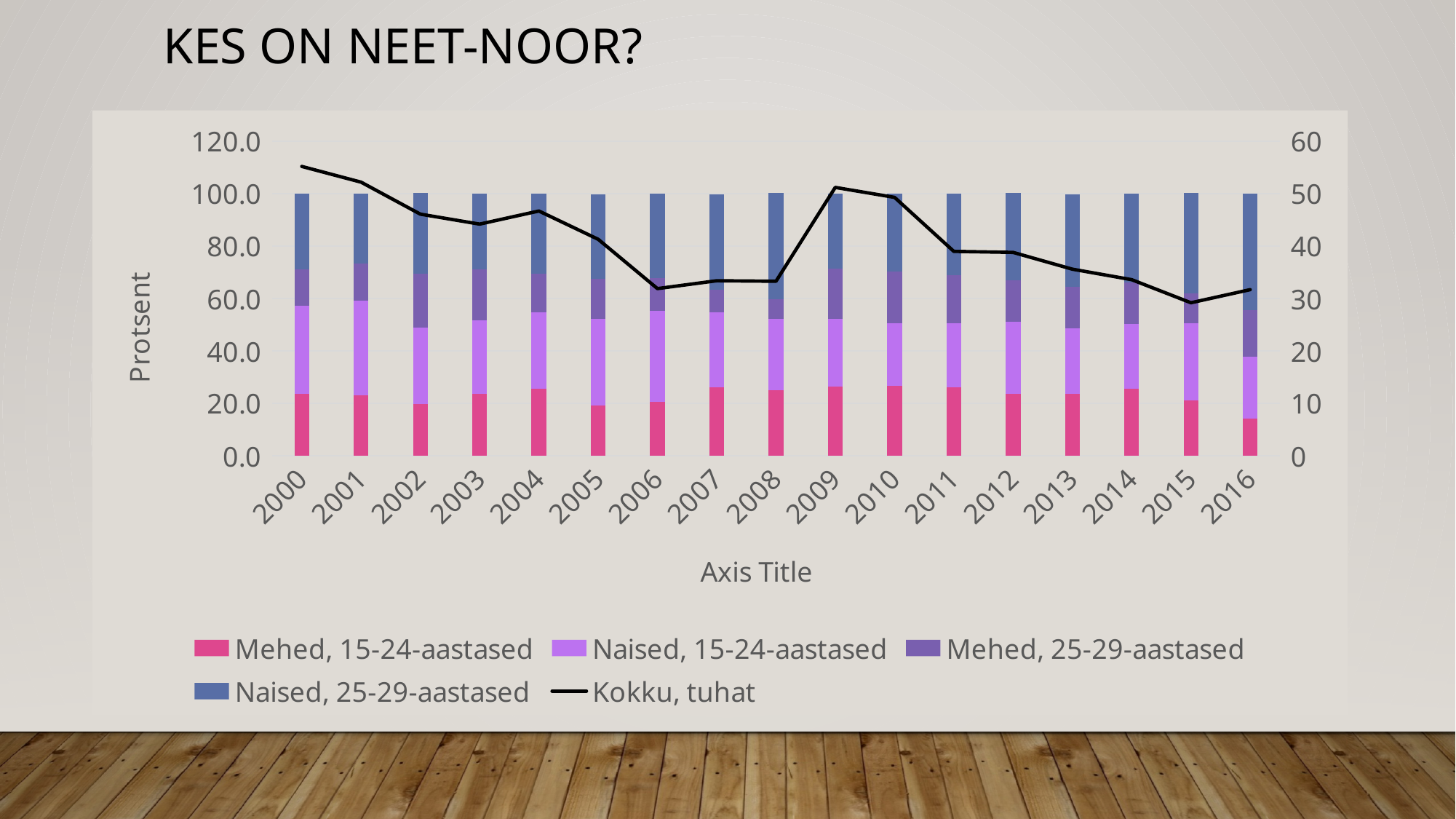
Does the 'Kokku, tuhat' line generally rise or fall from 2000 to 2016? fall How many years are shown along the x axis of the chart? 17 What is the total height of the stacked bar for 2008 on the left axis? 100.0 Is the 'Kokku, tuhat' value for 2015 greater or less than 40 on the right axis? less Is the 'Kokku, tuhat' value for 2000 greater or less than 50 on the right axis? greater How many series does the chart's legend list? 5 Which is larger, the 'Mehed, 15-24-aastased' value for 2010 or for 2016? 2010 What is the title of the left vertical axis? Protsent What kind of chart is shown on the slide? A stacked bar chart combined with a line In which year does the 'Kokku, tuhat' line reach its lowest value? 2015 In which year does the 'Kokku, tuhat' line reach its highest value? 2000 Is the 'Mehed, 15-24-aastased' value for 2016 greater or less than 20.0? less